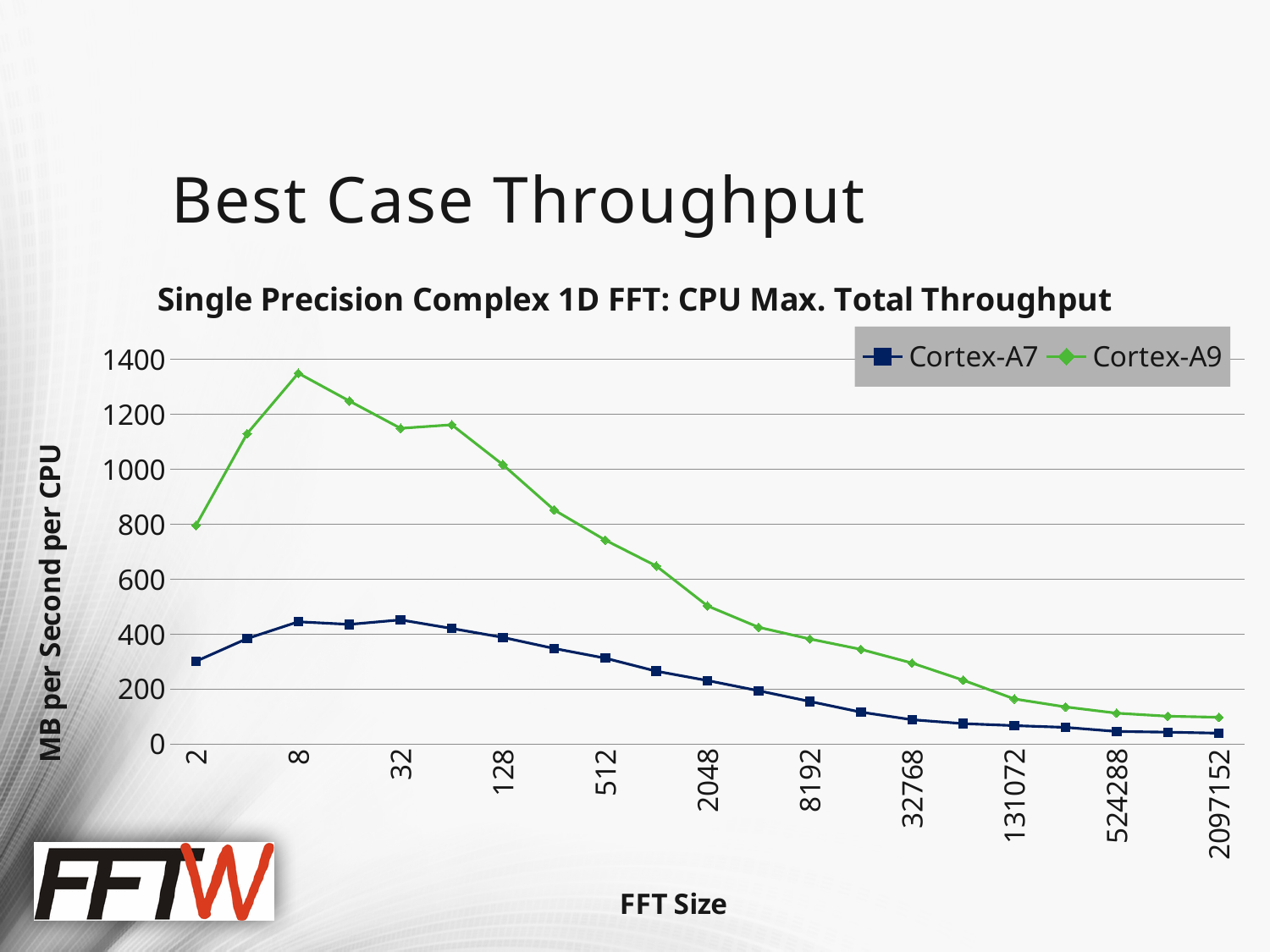
How many series does the legend list? 2 Is the Cortex-A9 value at FFT size 2048 greater or less than 400? greater Is the Cortex-A9 value at FFT size 2 greater or less than 1000? less Is the Cortex-A7 value at FFT size 2048 greater or less than 400? less What kind of chart is shown on the slide? line chart What is the label of the vertical axis? MB per Second per CPU At FFT size 2, which series has the higher throughput, Cortex-A7 or Cortex-A9? Cortex-A9 What is the title of the chart? Single Precision Complex 1D FFT: CPU Max. Total Throughput At which FFT size does the Cortex-A9 series reach its highest value? 8 Does the Cortex-A9 series rise or fall as FFT size increases from 8 to 2097152? fall